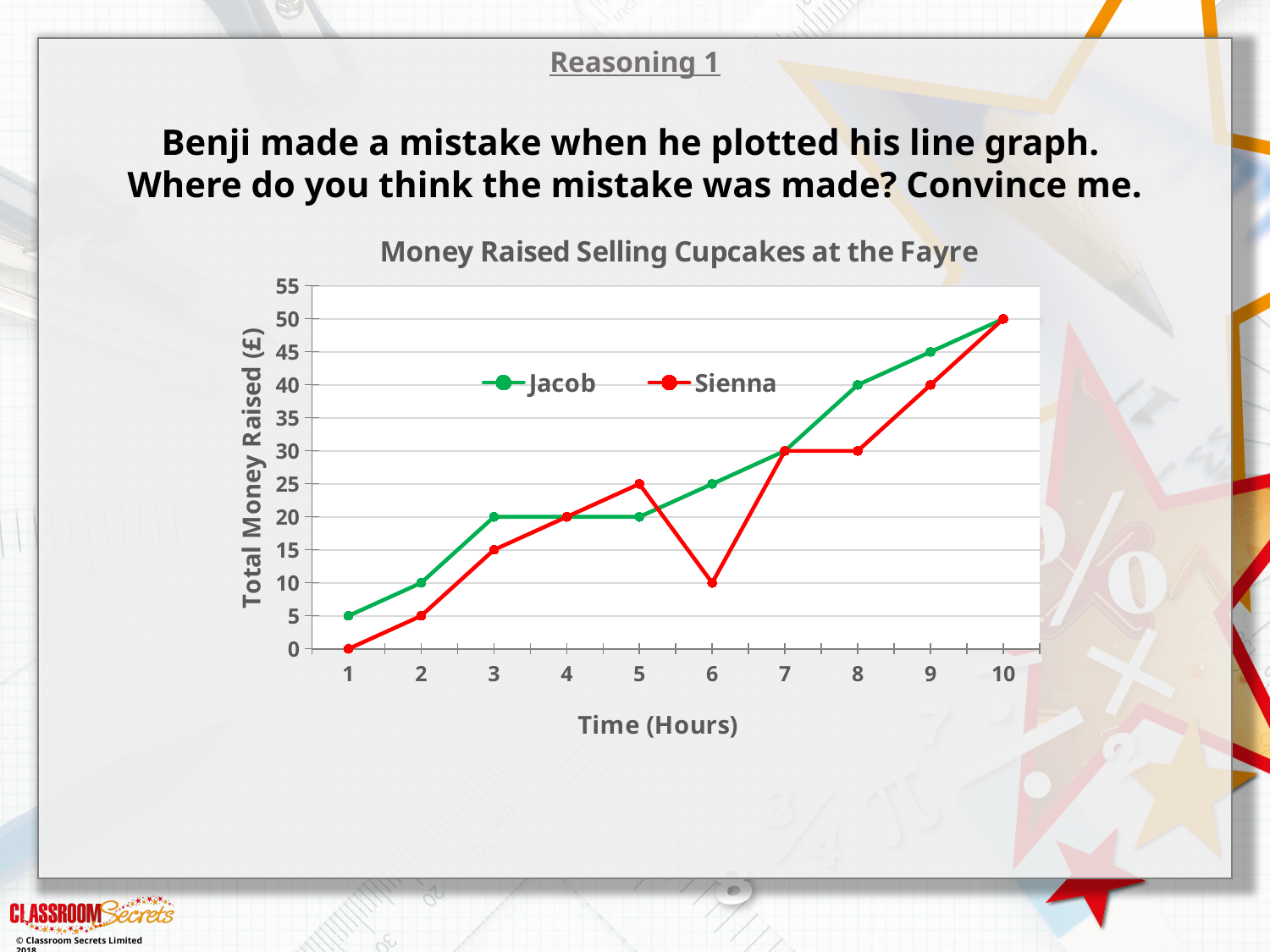
Which colour is used for Sienna's line? red What is the total money raised by Sienna at 6 hours? 10 Does Jacob's line generally rise or fall from 1 hour to 10 hours? rise What is the title of the chart? Money Raised Selling Cupcakes at the Fayre What is the total money raised by Jacob at 3 hours? 20 What is the difference between Jacob's and Sienna's values at 6 hours? 15 What is the total money raised by Sienna at 1 hour? 0 At which hour does Sienna's line reach its lowest value? 1 What kind of chart is shown on the slide? line chart How many time points are plotted along the x axis? 10 At 5 hours, who raised more money, Jacob or Sienna? Sienna How many series does the legend list? 2